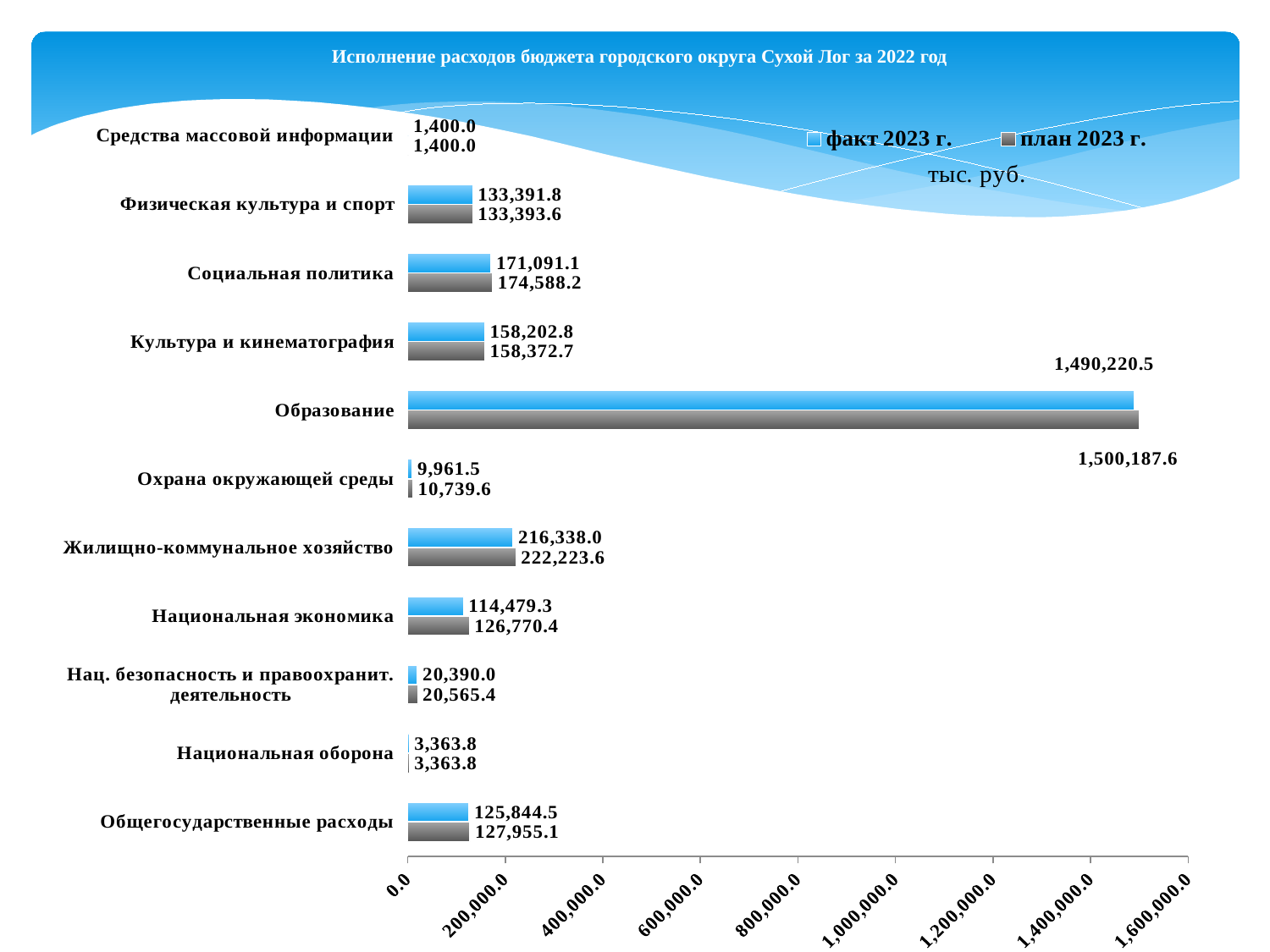
How many series does the legend list? 2 Which is larger: the 'факт 2023 г.' value for Социальная политика or for Культура и кинематография? Социальная политика What is the value of 'факт 2023 г.' for Охрана окружающей среды? 9,961.5 What is the title of the chart? Исполнение расходов бюджета городского округа Сухой Лог за 2022 год What type of chart is shown on the slide? Bar chart What is the difference between 'план 2023 г.' and 'факт 2023 г.' for Национальная экономика? 12,291.1 What unit of measurement is indicated on the chart? тыс. руб. What is the value of 'факт 2023 г.' for Образование? 1,490,220.5 Which category has the highest 'план 2023 г.' value? Образование What is the value of 'план 2023 г.' for Жилищно-коммунальное хозяйство? 222,223.6 How many categories are shown on the chart? 11 Which category has the lowest 'факт 2023 г.' value? Средства массовой информации